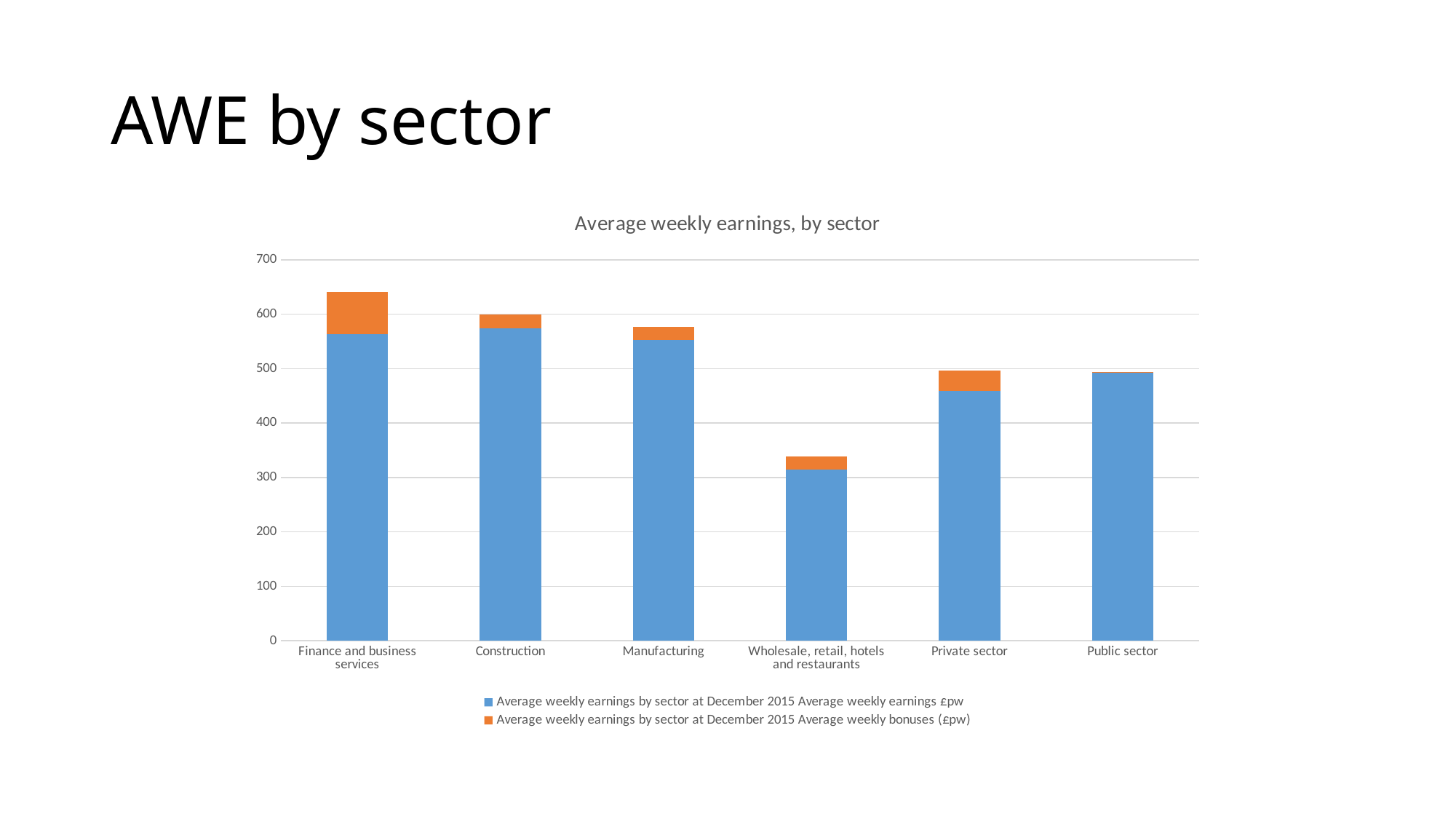
How many sectors are shown on the x axis of the chart? 6 Which sector has the largest average weekly bonuses segment? Finance and business services Which sector has the tallest stacked bar overall? Finance and business services Is the average weekly earnings value for Manufacturing greater or less than 500? greater What kind of chart is shown on the slide? bar chart What is the title of the chart? Average weekly earnings, by sector Which has higher average weekly earnings, Public sector or Private sector? Public sector Is the average weekly earnings value for Private sector greater or less than 500? less How many series does the chart's legend list? 2 Which colour represents average weekly bonuses in the chart? orange Is the average weekly earnings value for Wholesale, retail, hotels and restaurants greater or less than 400? less Which sector has the shortest stacked bar overall? Wholesale, retail, hotels and restaurants